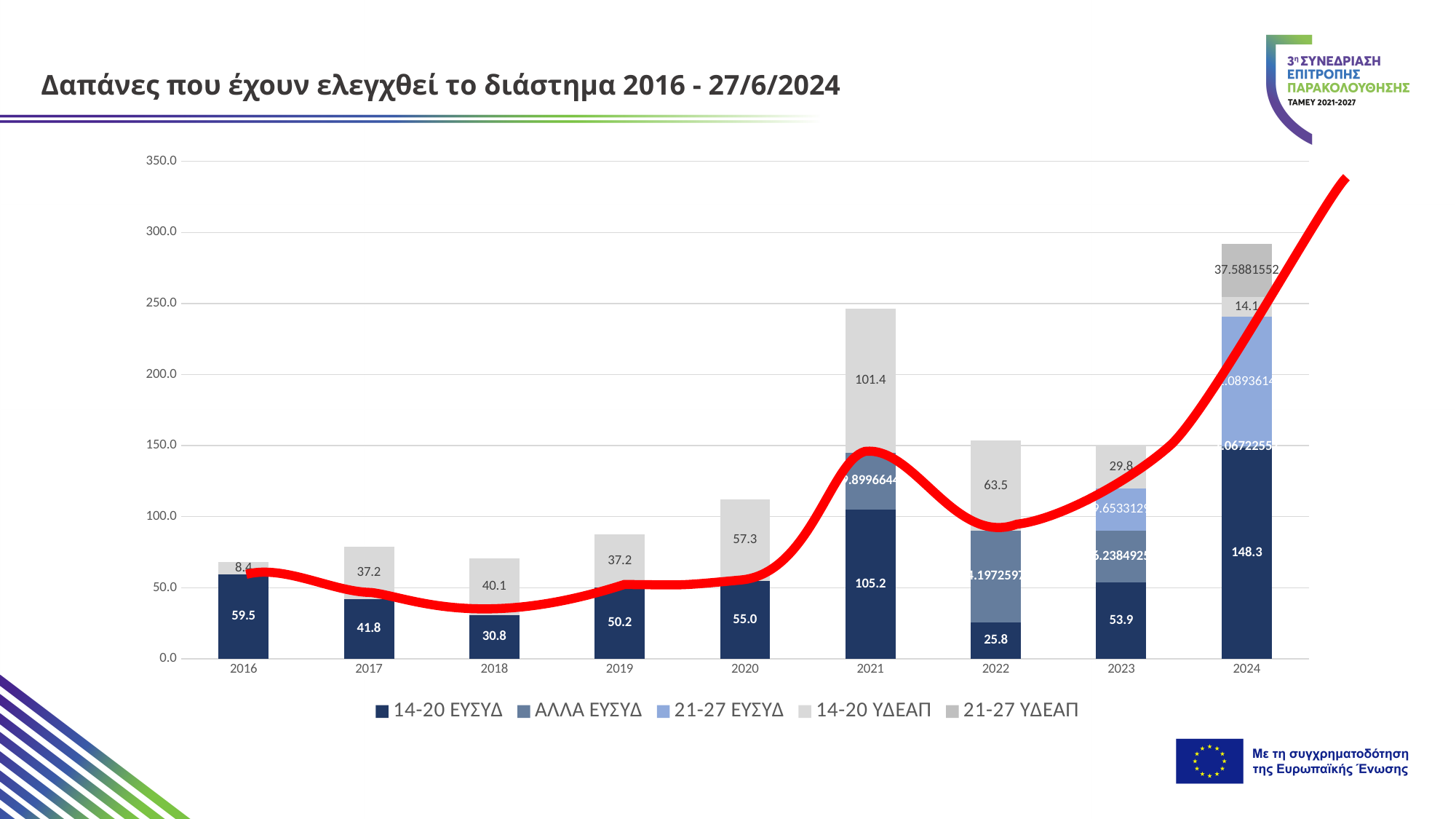
What is the value of the 14-20 ΥΔΕΑΠ series for 2021? 101.4 In which year is the 14-20 ΕΥΣΥΔ value the lowest? 2022 What is the value of the 21-27 ΥΔΕΑΠ series for 2024? 37.5881552 What is the difference between the 14-20 ΕΥΣΥΔ values for 2024 and 2021? 43.1 Which year has the larger 14-20 ΥΔΕΑΠ value, 2020 or 2022? 2022 How many series does the legend list? 5 What is the total of the stacked bar for 2016? 67.9 In which year is the 14-20 ΥΔΕΑΠ value the lowest? 2016 In which year is the 14-20 ΕΥΣΥΔ value the highest? 2024 What is the value of the 14-20 ΕΥΣΥΔ series for 2024? 148.3 Is the total height of the stacked bar for 2021 greater or less than 200? greater How many years are shown on the x axis? 9